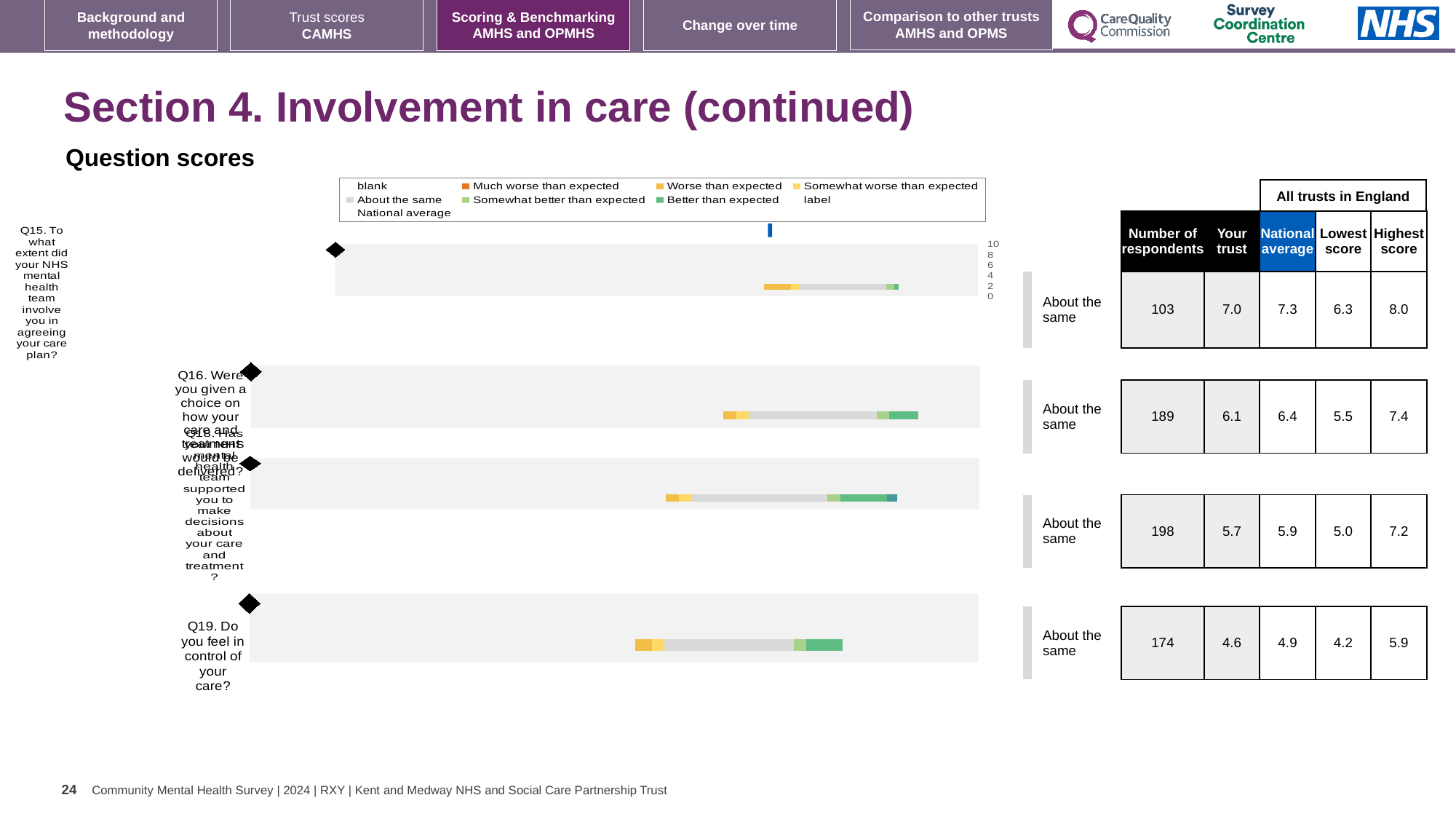
In the table beside the chart, how many respondents are listed for Q16? 189 In the legend of the question scores chart, what colour represents 'Much worse than expected'? orange In the table beside the chart, for Q16 which is larger: the 'Your trust' score or the national average? National average What is the heading printed above the question scores chart? Question scores How many questions (categories) are plotted in the question scores chart? 4 What kind of chart is used to show the question scores on this slide? bar chart In the table beside the chart, what is the difference between the national average and the 'Your trust' score for Q15? 0.3 In the table beside the chart, what is the national average for Q19? 4.9 In the table beside the chart, which question has the highest number of respondents? Q18 How many entries does the legend of the question scores chart list? 9 In the table beside the chart, what is the 'Your trust' score for Q15? 7.0 In the table beside the chart, which question has the lowest 'Your trust' score? Q19